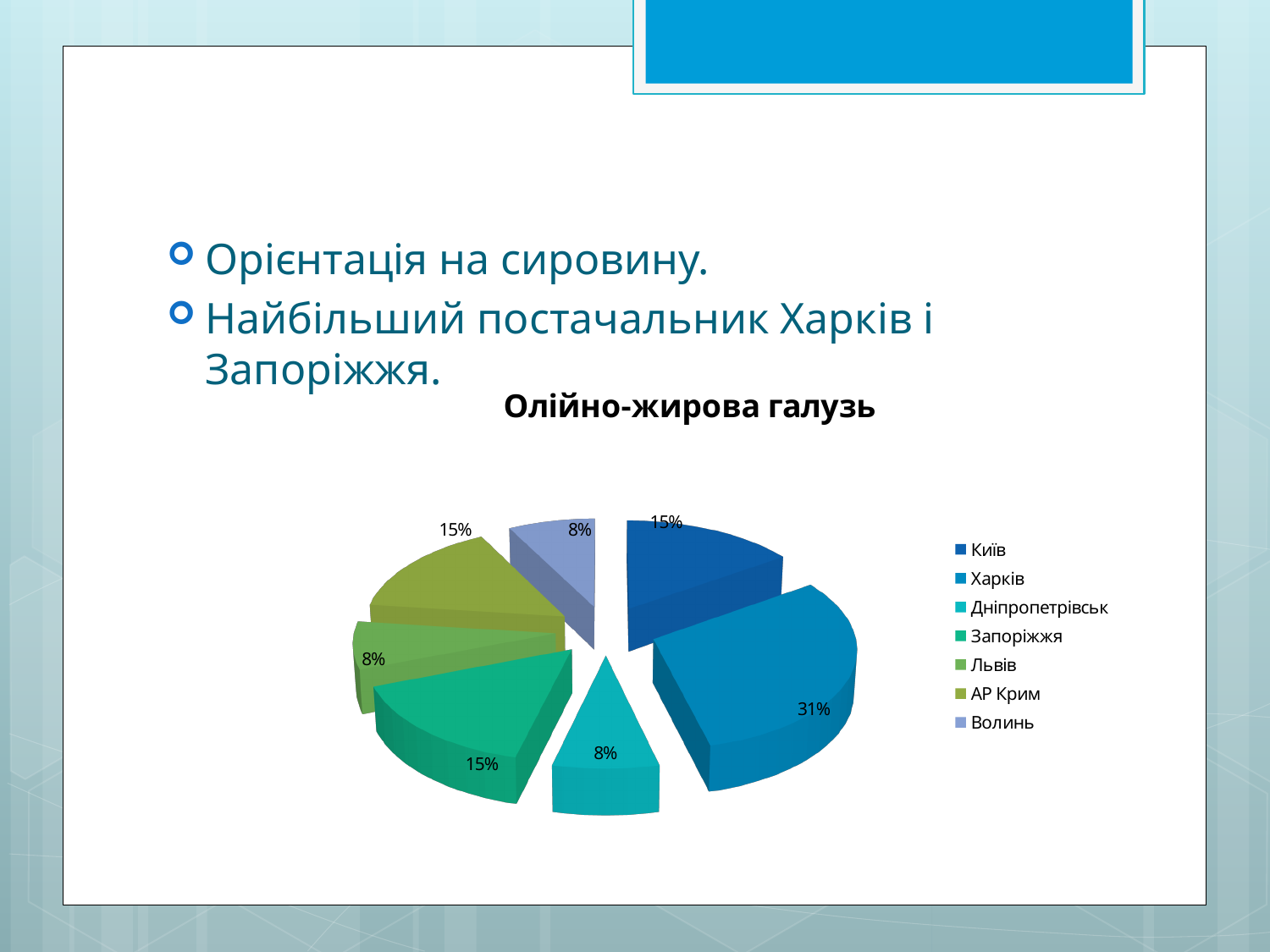
Which category has the largest slice of the pie? Харків Which is larger, the value for Харків or the value for Запоріжжя? Харків What is the value for Київ? 15% What kind of chart is shown on the slide? pie chart What is the title of the chart? Олійно-жирова галузь What share of the pie does Харків have? 31% How many entries does the legend list? 7 How many categories does the pie chart have? 7 What is the value for Дніпропетровськ? 8% What is the difference between the values for Харків and Київ? 16 percentage points What is the value for Запоріжжя? 15% What is the value for Волинь? 8%